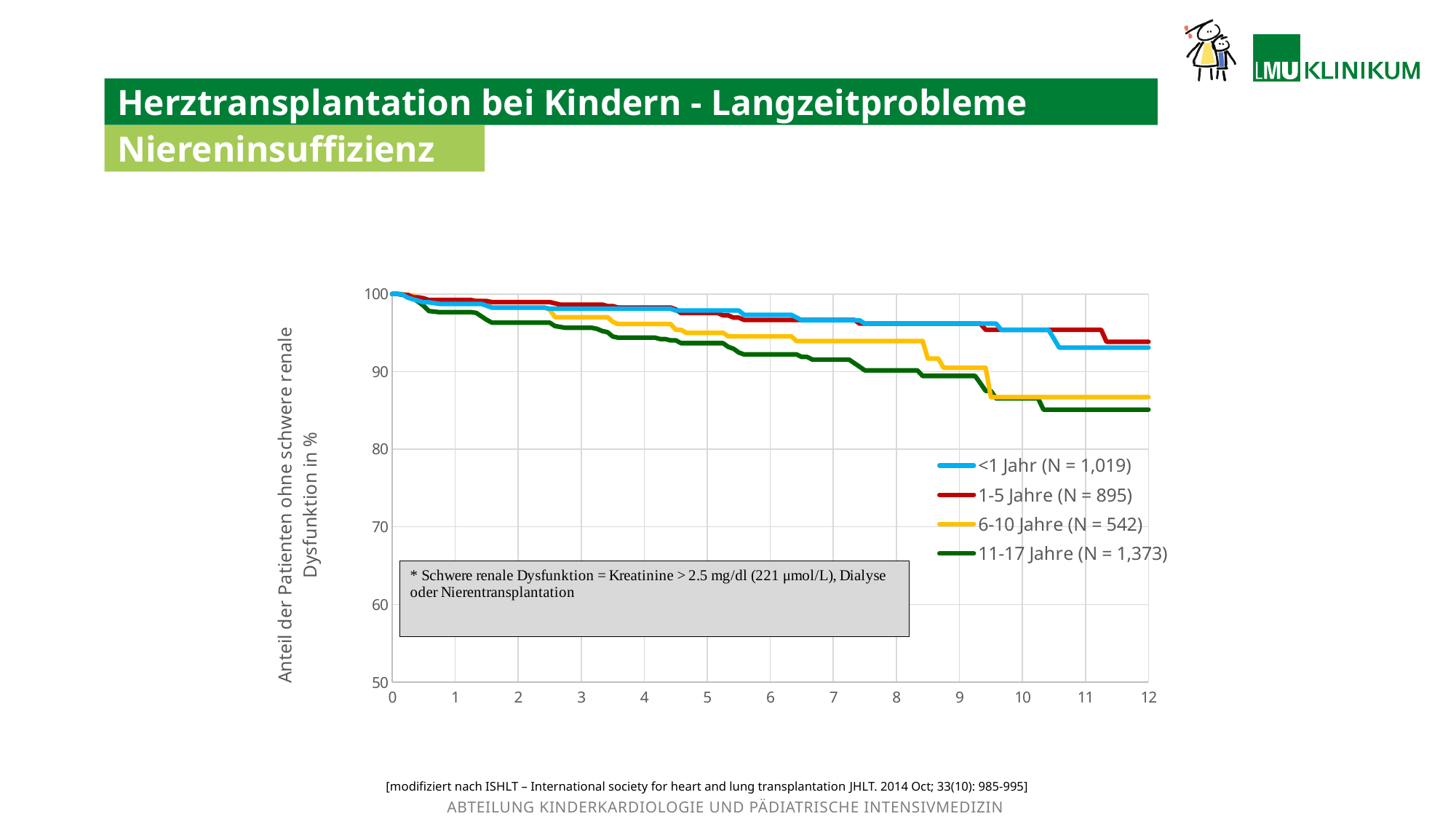
Which series has the lowest value at year 12? 11-17 Jahre Is the value for the 6-10 Jahre series at year 12 greater or less than 90? less How many series does the legend list? 4 What kind of chart is shown on the slide? line chart Is the value for the 11-17 Jahre series at year 12 greater or less than 90? less Is the value for the <1 Jahr series at year 12 greater or less than 90? greater At year 12, which is larger: the value for <1 Jahr or the value for 11-17 Jahre? <1 Jahr What is the N given in the legend for the 11-17 Jahre series? 1,373 Do the values of the 11-17 Jahre series rise or fall along the x axis? fall Which series in the legend has N = 542? 6-10 Jahre What is the highest value shown on the y axis? 100